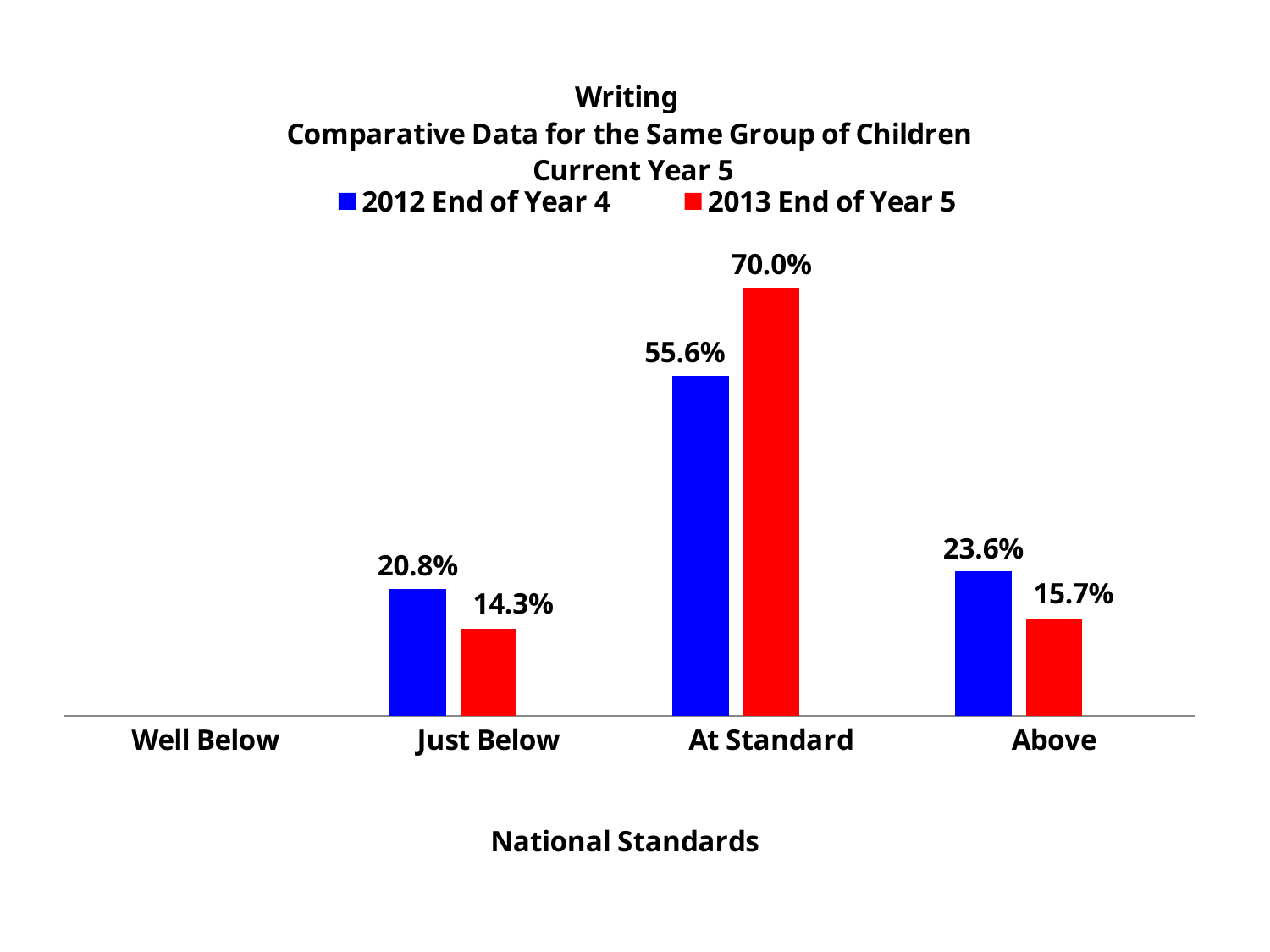
What is the difference between the 2012 End of Year 4 and 2013 End of Year 5 values in the Above category? 7.9% What is the value for 2013 End of Year 5 in the Above category? 15.7% What is the value for 2012 End of Year 4 in the At Standard category? 55.6% In the Just Below category, which series has the larger value, 2012 End of Year 4 or 2013 End of Year 5? 2012 End of Year 4 Which category has the highest value for 2013 End of Year 5? At Standard How many series does the legend list? 2 What is the x-axis title of the chart? National Standards What is the difference between the 2013 End of Year 5 and 2012 End of Year 4 values in the At Standard category? 14.4% What kind of chart is shown on the slide? bar chart How many categories are shown on the x axis? 4 What is the value for 2013 End of Year 5 in the Just Below category? 14.3% Which category has the lowest value for 2012 End of Year 4 among those with a labelled bar? Just Below